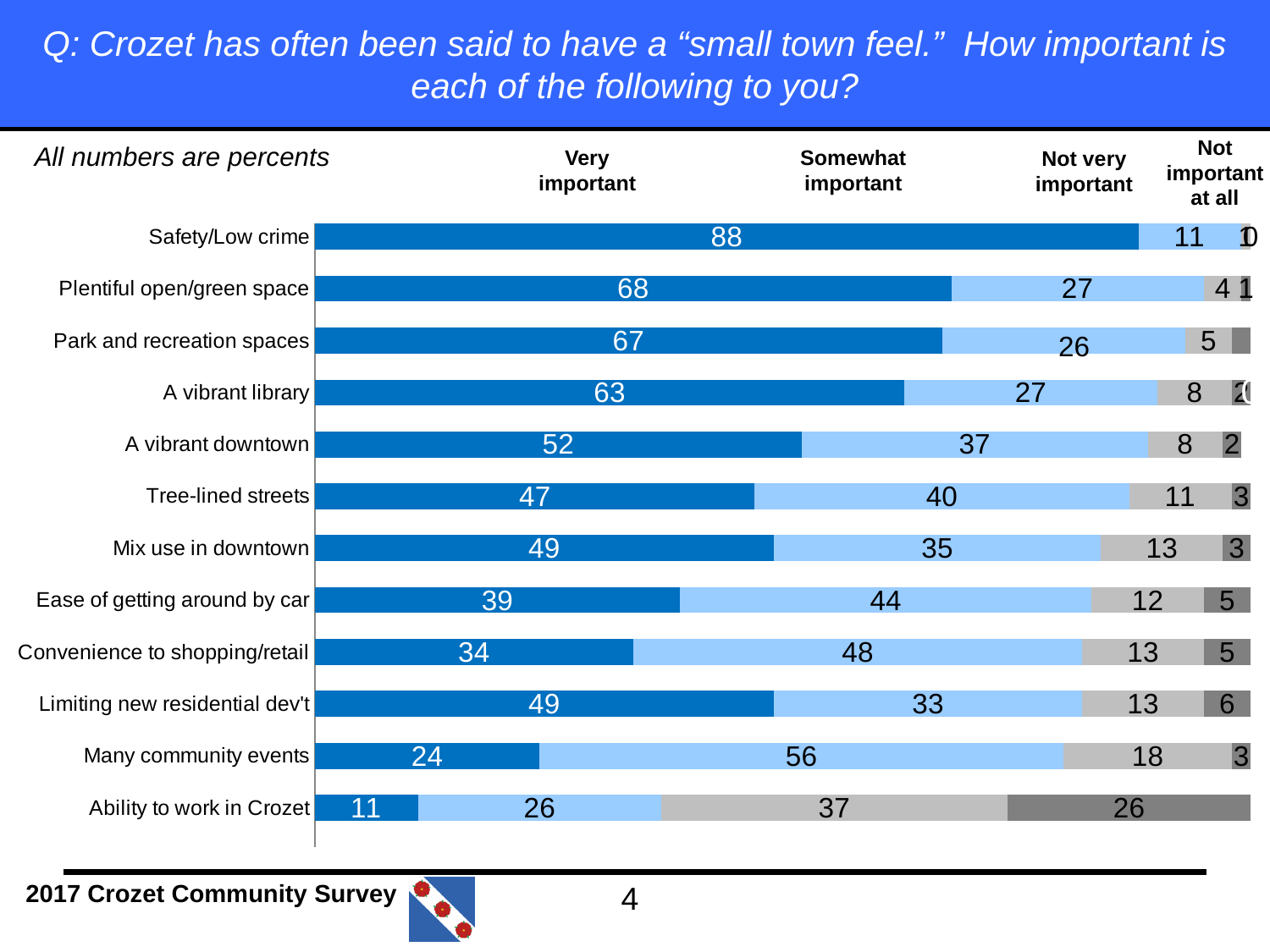
What percentage rated Safety/Low crime as Very important? 88 Which item has the highest Very important percentage? Safety/Low crime What percentage rated Many community events as Somewhat important? 56 Which item has the lowest Very important percentage? Ability to work in Crozet What is the total of the four segments for Ability to work in Crozet? 100 What kind of chart is shown on the slide? Stacked bar chart Which has a larger Very important percentage, A vibrant downtown or Tree-lined streets? A vibrant downtown What percentage rated Limiting new residential dev't as Not important at all? 6 How many response categories (series) does the chart show? 4 What is the difference between the Somewhat important percentages for Tree-lined streets and Mix use in downtown? 5 How many items are listed in the chart? 12 What percentage rated Ability to work in Crozet as Not very important? 37